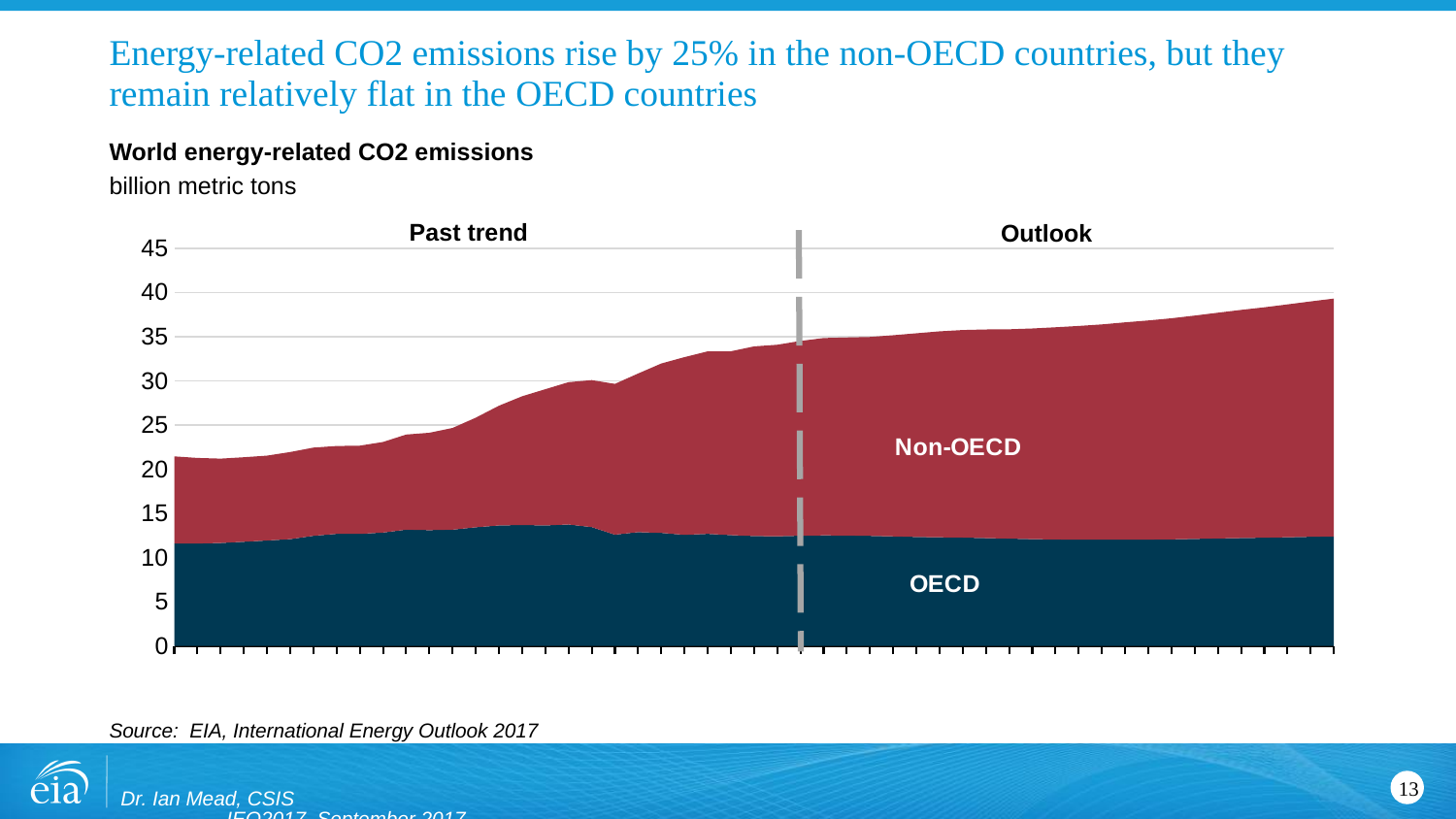
Do total emissions rise or fall across the Outlook period? rise Is the OECD value at the right end of the Outlook period greater or less than 15? less Which series is larger at the right end of the Outlook period, OECD or Non-OECD? Non-OECD How many series are plotted in the chart? 2 Is the total emissions value at the right end of the Outlook period greater or less than 40? less Which series is plotted at the bottom of the stacked area chart? OECD Is the OECD value at the right end of the Outlook period greater or less than 10? greater What is the title of the chart? World energy-related CO2 emissions What kind of chart is shown on the slide? Stacked area chart What are the two series shown in the chart? Non-OECD and OECD